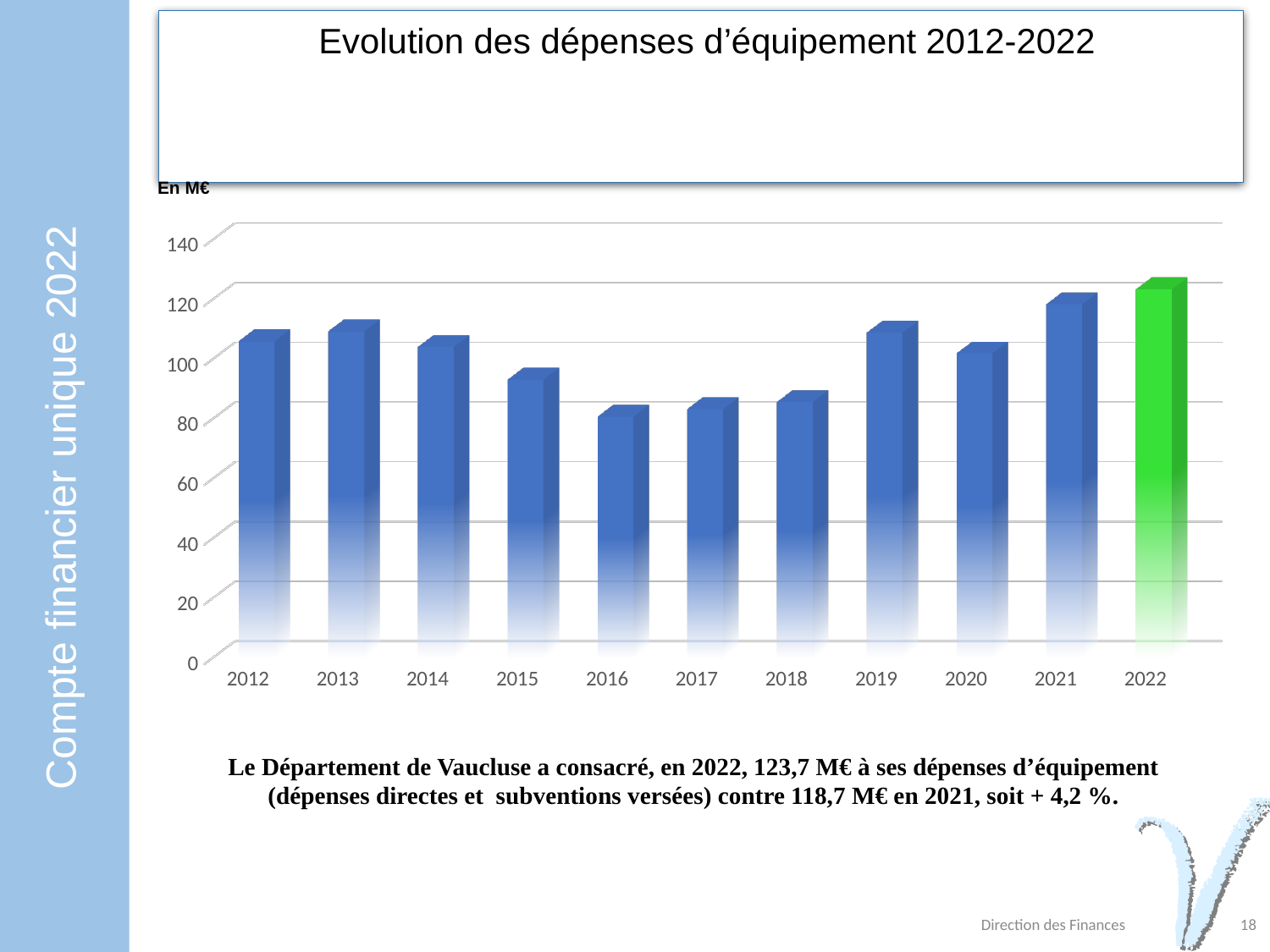
Do the values rise or fall from 2012 to 2016? fall Which year has the highest equipment spending in the chart? 2022 By how much did equipment expenses increase from 2021 to 2022, in M€? 5 M€ Which year has the lowest equipment spending in the chart? 2016 Is the value for 2016 greater or less than 100? less What unit is indicated above the chart? En M€ Is the value for 2013 greater or less than 100? greater According to the slide, what were the equipment expenses in 2022? 123,7 M€ Which year has the larger value, 2013 or 2014? 2013 According to the slide, what were the equipment expenses in 2021? 118,7 M€ How many years are plotted on the x axis of the chart? 11 What kind of chart is shown on the slide? bar chart